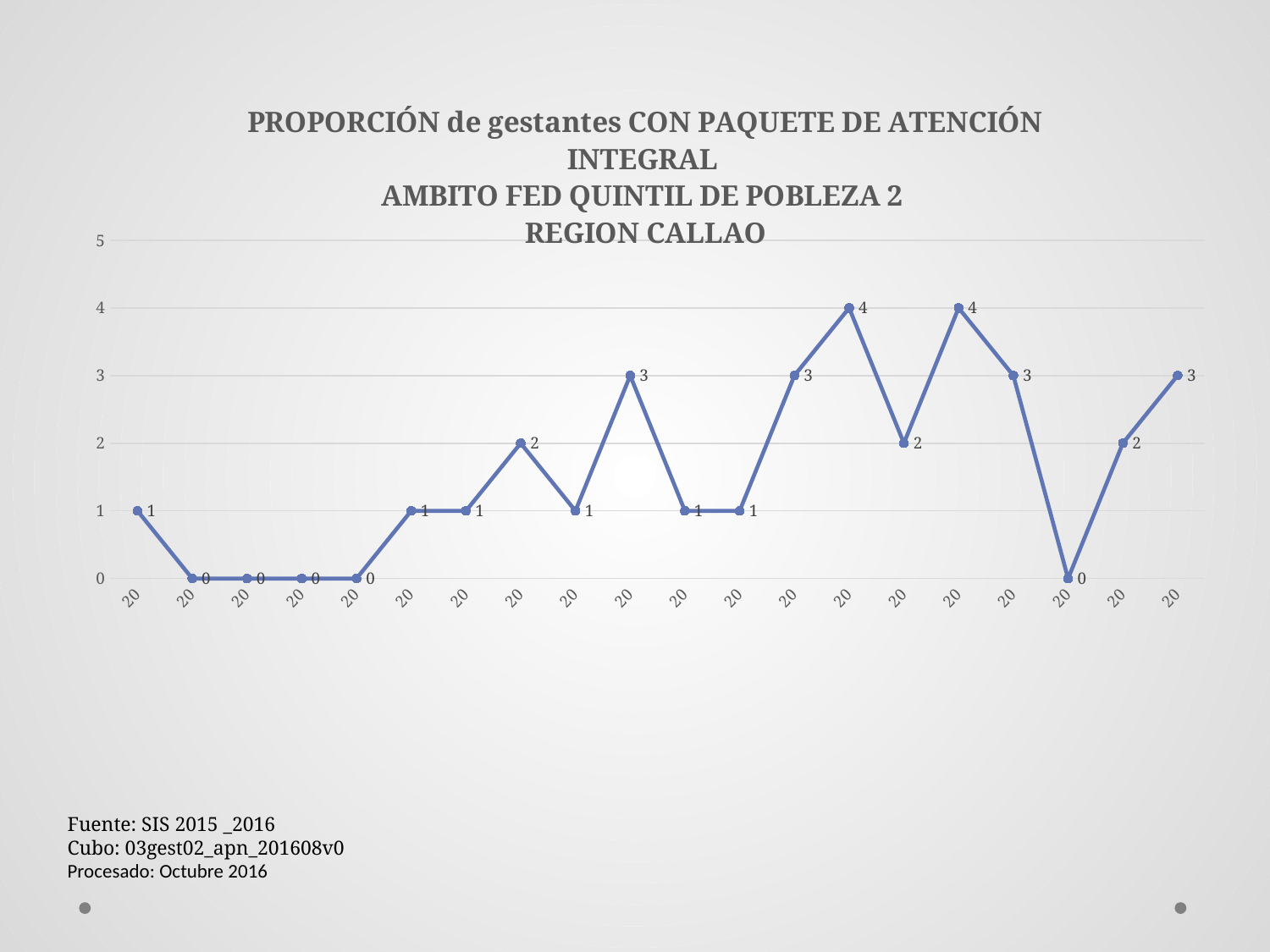
What is the value of the tenth point from the left? 3 How many data points are plotted on the line? 20 What is the difference between the last point's value and the first point's value? 2 What kind of chart is shown on the slide? line chart What is the highest value reached by the line? 4 How many points on the line have a value of 4? 2 What is the value of the first point on the line? 1 What is the value of the last point on the line? 3 Which region is named in the chart title? REGION CALLAO How many points on the line have a value of 0? 5 What is the lowest value reached by the line? 0 Is the last point on the line higher or lower than the first point? higher